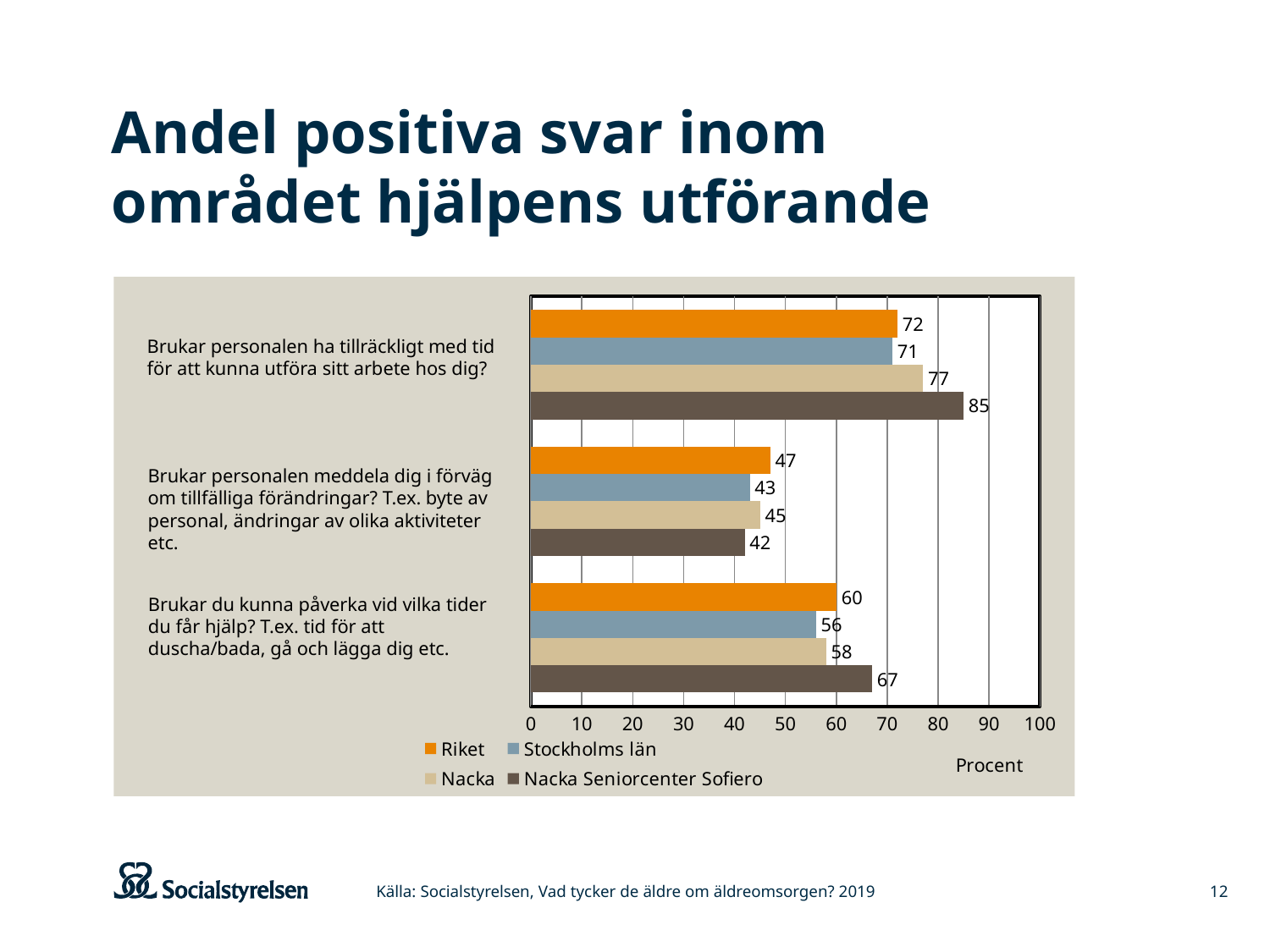
Which series has the lowest value on the question "Brukar personalen meddela dig i förväg om tillfälliga förändringar?"? Nacka Seniorcenter Sofiero Is the value for Nacka on the question "Brukar personalen ha tillräckligt med tid för att kunna utföra sitt arbete hos dig?" greater or less than 70? greater What is the difference between Nacka Seniorcenter Sofiero and Riket on the question "Brukar personalen ha tillräckligt med tid för att kunna utföra sitt arbete hos dig?"? 13 What is the value for Stockholms län on the question "Brukar du kunna påverka vid vilka tider du får hjälp?"? 56 How many series does the legend list? 4 What is the value for Riket on the question "Brukar personalen meddela dig i förväg om tillfälliga förändringar?"? 47 What kind of chart is shown on the slide? bar chart What is the value for Nacka Seniorcenter Sofiero on the question "Brukar personalen ha tillräckligt med tid för att kunna utföra sitt arbete hos dig?"? 85 Which series has the highest value on the question "Brukar du kunna påverka vid vilka tider du får hjälp?"? Nacka Seniorcenter Sofiero How many questions (categories) are shown on the chart? 3 Which is larger on the question "Brukar du kunna påverka vid vilka tider du får hjälp?": Riket or Nacka? Riket What is the label of the horizontal axis? Procent